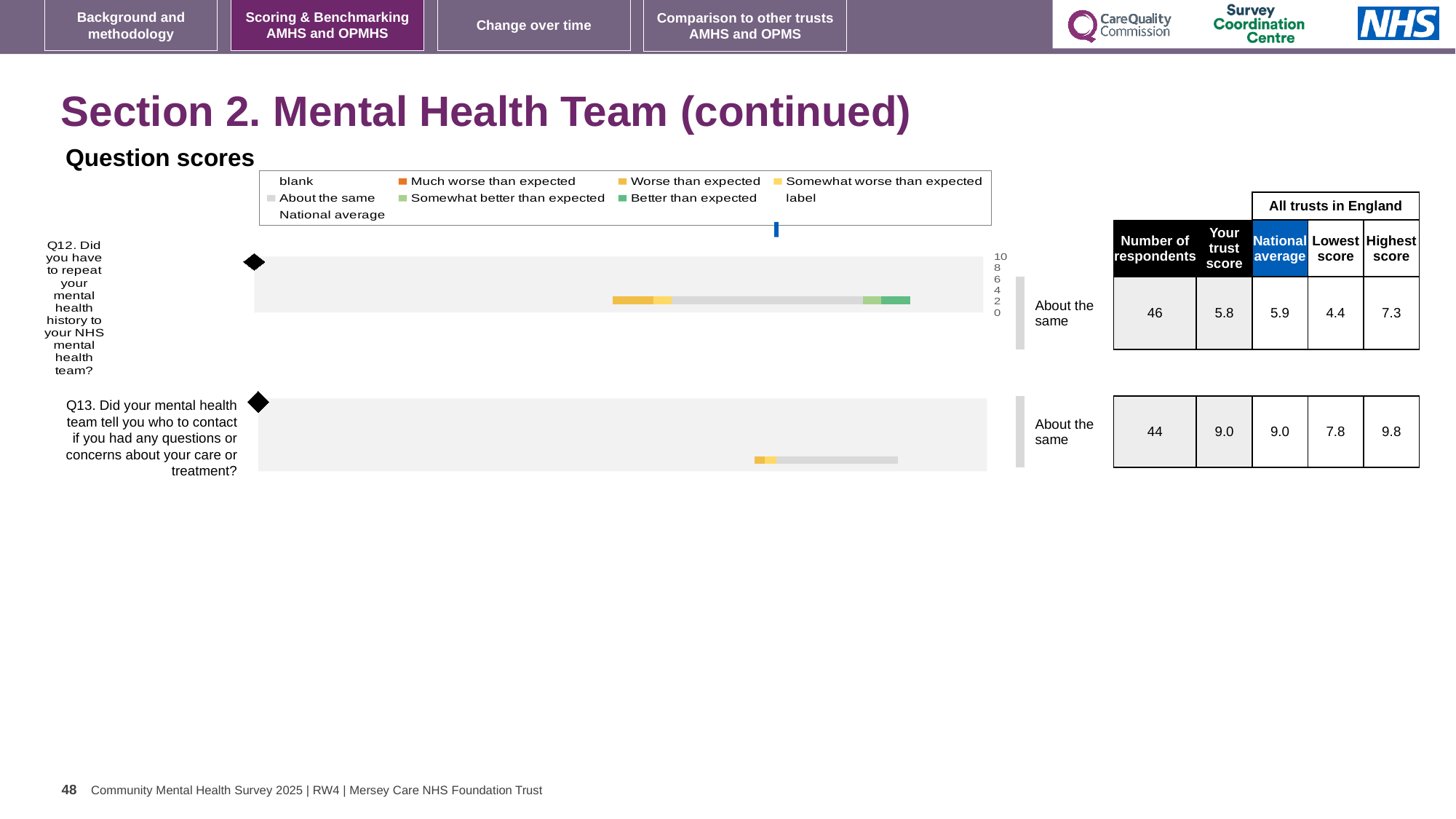
What kind of chart is used to show the question scores for Q12 and Q13? bar chart For Q12 (repeating mental health history), what is the highest score among all trusts in England? 7.3 What benchmark category is shown next to the Q12 chart? About the same For Q13 (who to contact with questions or concerns), what is your trust score? 9.0 For Q12 (repeating mental health history), what is your trust score? 5.8 How many questions (chart rows) are shown on the slide? 2 For Q13 (who to contact with questions or concerns), what is the lowest score among all trusts in England? 7.8 What is the difference between the highest and lowest scores for Q12 (repeating mental health history)? 2.9 What is the difference between the highest and lowest scores for Q13 (who to contact with questions or concerns)? 2.0 For Q12 (repeating mental health history), what is the number of respondents? 46 Which question has the higher trust score, Q12 or Q13? Q13 For Q12 (repeating mental health history), what is the national average? 5.9